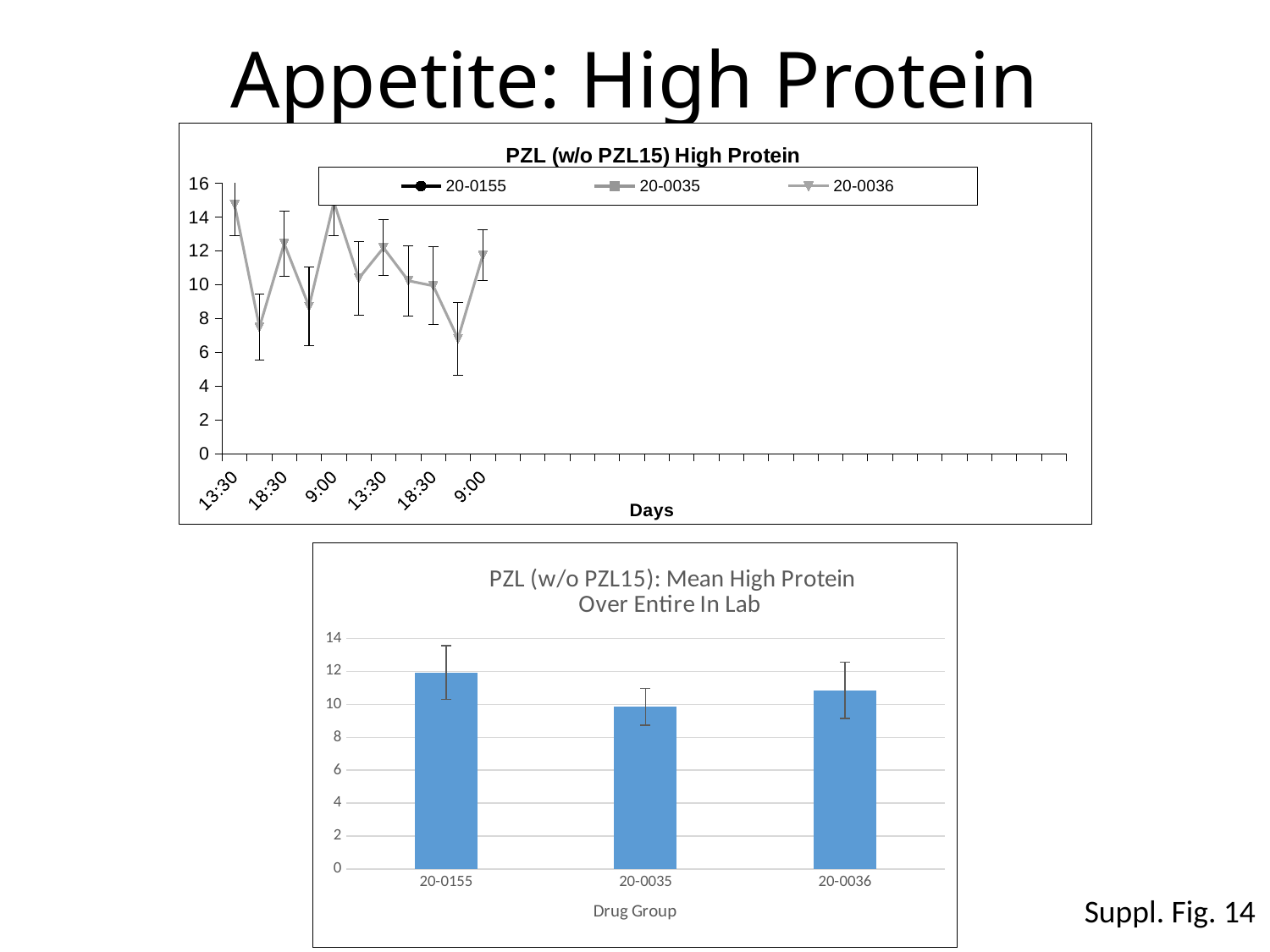
What is the x-axis title of the bottom chart? Drug Group In the bottom chart, how many drug groups are shown on the x axis? 3 In the bottom chart, which is larger, the value for 20-0155 or the value for 20-0035? 20-0155 What kind of chart is the bottom chart, "PZL (w/o PZL15): Mean High Protein Over Entire In Lab"? bar chart What kind of chart is the top chart, "PZL (w/o PZL15) High Protein"? line chart In the bottom chart, which drug group has the lowest mean high protein value? 20-0035 How many series does the legend of the top chart list? 3 What is the x-axis title of the top chart? Days In the bottom chart, is the value for 20-0155 greater or less than 10? greater In the bottom chart, which drug group has the highest mean high protein value? 20-0155 In the bottom chart, is the value for 20-0035 greater or less than 8? greater In the bottom chart, is the value for 20-0036 greater or less than 12? less